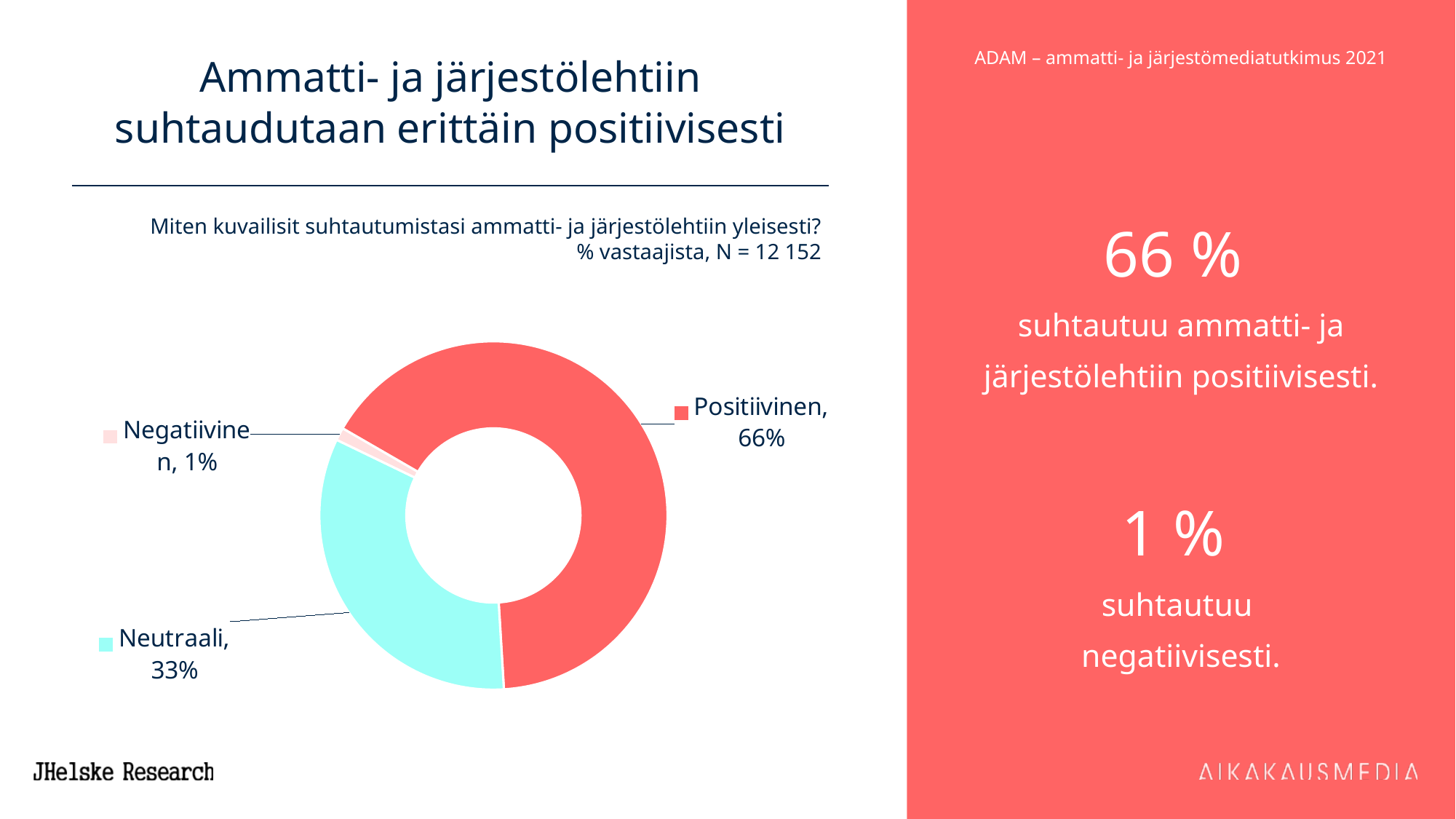
What share of respondents answered Positiivinen? 66% What kind of chart is shown on the slide? Pie chart (doughnut) What is the difference in percentage points between Neutraali and Negatiivinen? 32 What is the difference in percentage points between Positiivinen and Neutraali? 33 Which category has the largest share of the pie? Positiivinen What is the number of respondents (N) stated above the chart? 12 152 How many categories does the pie chart show? 3 Which is larger, the share for Neutraali or the share for Negatiivinen? Neutraali What share of respondents answered Neutraali? 33% What share of respondents answered Negatiivinen? 1% Which category has the smallest share of the pie? Negatiivinen What colour is the Neutraali slice of the pie chart? Light blue (cyan)